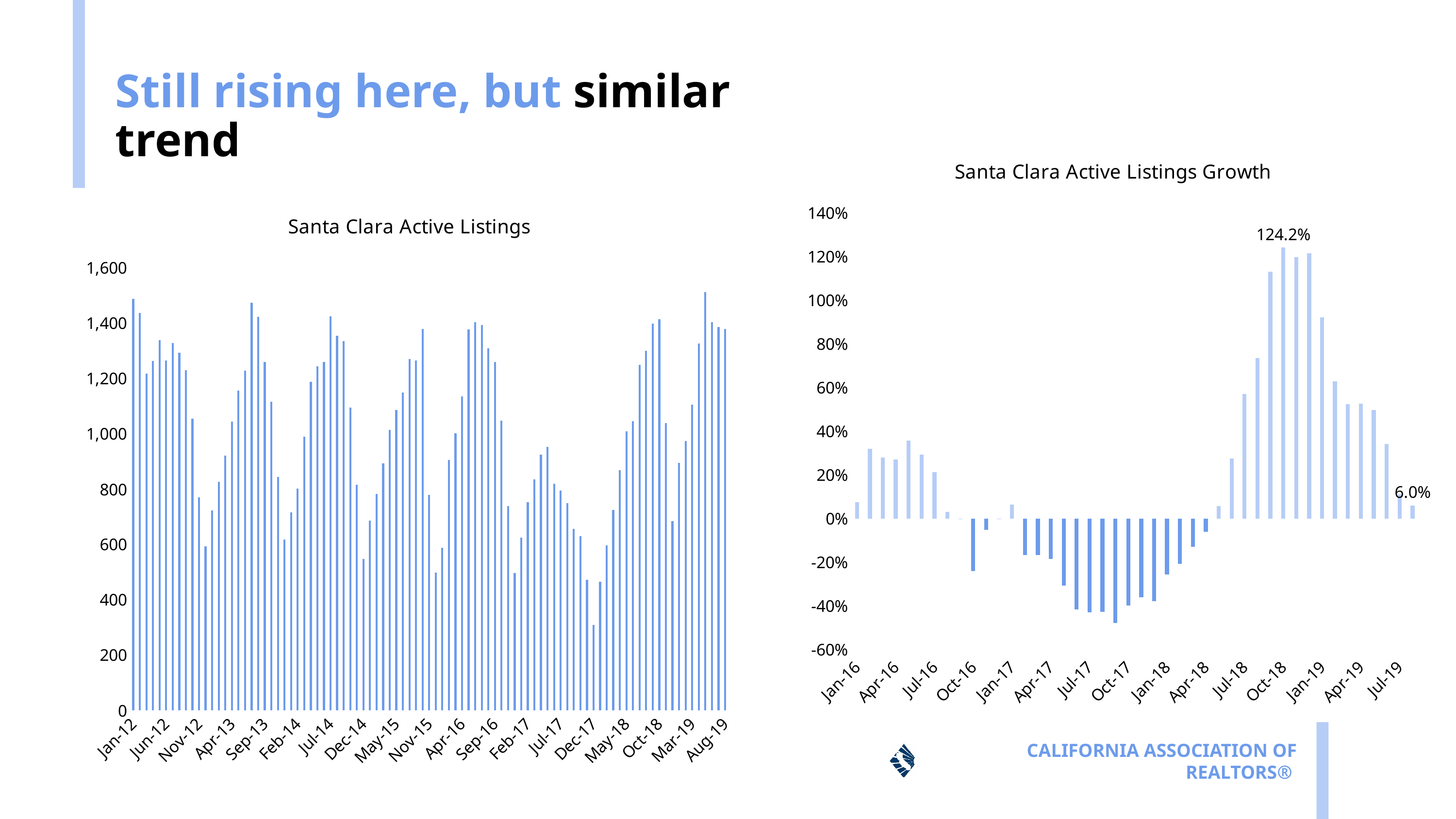
In the 'Santa Clara Active Listings Growth' chart, what value is labelled on the last bar at the right end of the chart? 6.0% What is the title of the chart on the right side of the slide? Santa Clara Active Listings Growth What is the title of the chart on the left side of the slide? Santa Clara Active Listings In the 'Santa Clara Active Listings Growth' chart, is the value for Jan-16 greater or less than 20%? less What kind of chart is the 'Santa Clara Active Listings' chart on the left? bar chart In the 'Santa Clara Active Listings' chart, is the value for Jan-12 greater or less than 1,400? greater In the 'Santa Clara Active Listings Growth' chart, what is the highest value labelled on the chart? 124.2% In the 'Santa Clara Active Listings' chart, is the value for Dec-17 greater or less than 600? less In the 'Santa Clara Active Listings' chart, which is larger, the value for Jan-12 or the value for Dec-17? Jan-12 What kind of chart is the 'Santa Clara Active Listings Growth' chart on the right? bar chart In the 'Santa Clara Active Listings Growth' chart, do the values rise or fall from Oct-18 to Jul-19? fall